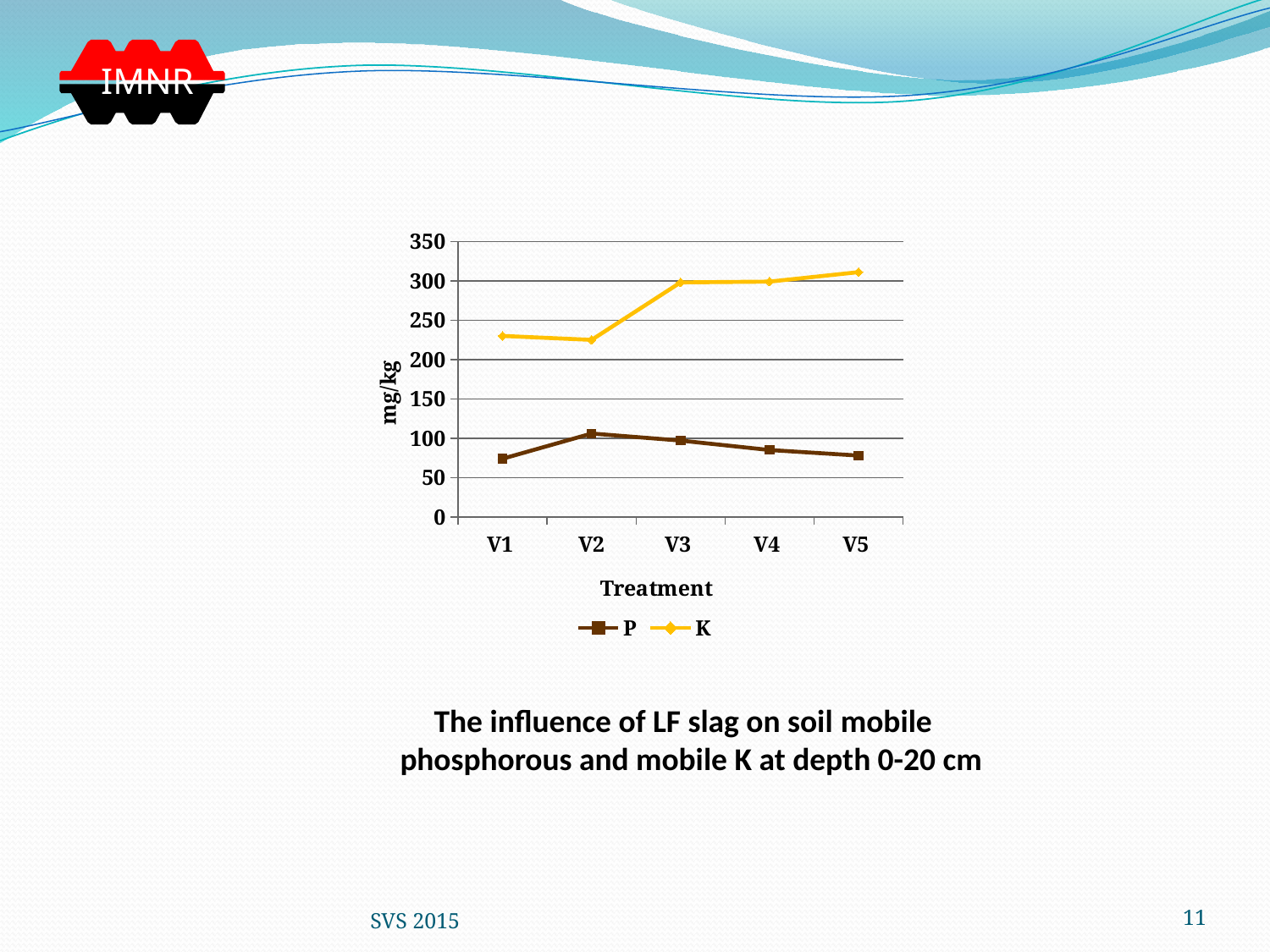
Is the value of P for treatment V5 greater or less than 100? less How many series does the legend list? 2 What is the label on the y axis? mg/kg Is the value of K for treatment V1 greater or less than 200? greater How many treatments are shown on the x axis? 5 At treatment V3, which series has the larger value, P or K? K Is the value of K for treatment V2 greater or less than 250? less What kind of chart is shown on the slide? line chart For which treatment is the K series highest? V5 For which treatment is the P series highest? V2